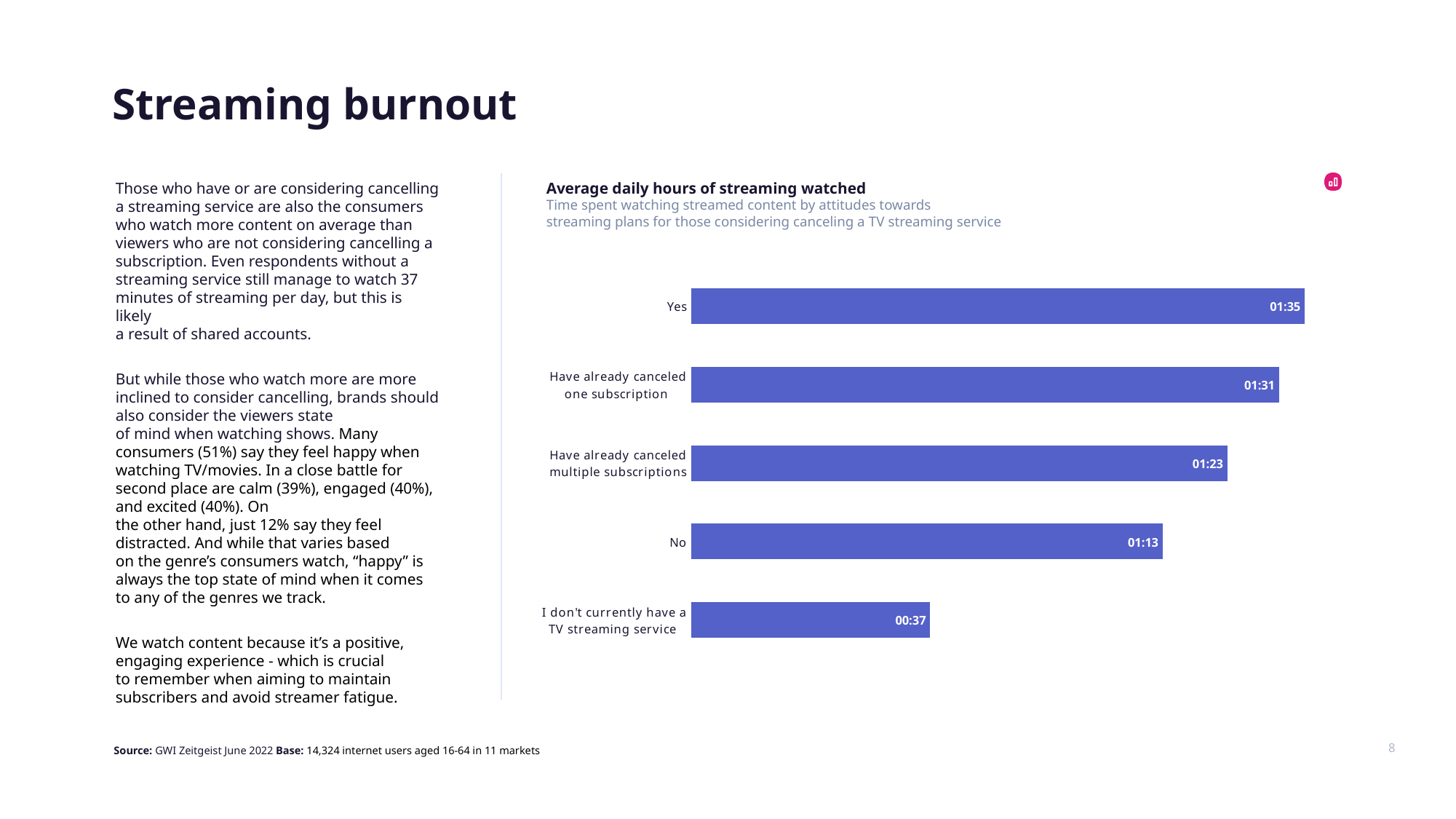
Which category has the lowest average daily hours of streaming watched? I don't currently have a TV streaming service Which is larger: the value for "Have already canceled one subscription" or for "Have already canceled multiple subscriptions"? Have already canceled one subscription What value is shown for "Have already canceled one subscription"? 01:31 What value is shown for "Have already canceled multiple subscriptions"? 01:23 What is the title of the chart? Average daily hours of streaming watched What type of chart is shown on the slide? Bar chart What is the average daily hours of streaming watched for respondents who answered "Yes"? 01:35 Which category has the highest average daily hours of streaming watched? Yes What value is shown for "I don't currently have a TV streaming service"? 00:37 How many categories are shown in the chart? 5 What is the value for respondents who answered "No"? 01:13 How many minutes more do "Yes" respondents watch per day than "No" respondents? 22 minutes